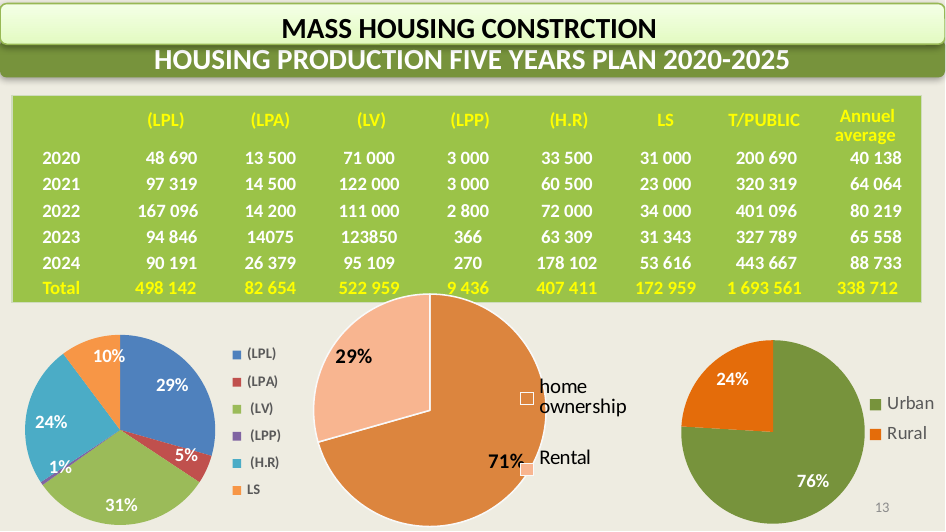
In the left pie chart, which category has the smallest slice? (LPP) In the left pie chart, what share does LS have? 10% In the middle pie chart, what is the share of the larger slice? 71% In the left pie chart, which is larger, the share of (LPL) or the share of (H.R)? (LPL) In the right pie chart, what share does Urban have? 76% In the left pie chart, what share does (LV) have? 31% In the left pie chart, what is the difference between the shares of (LPL) and (LPA)? 24% In the left pie chart, how many categories does the legend list? 6 What type of chart is the right chart showing Urban and Rural? Pie chart In the left pie chart, which category has the largest slice? (LV) In the right pie chart, what is the difference between the Urban and Rural shares? 52% In the left pie chart, what share does (H.R) have? 24%